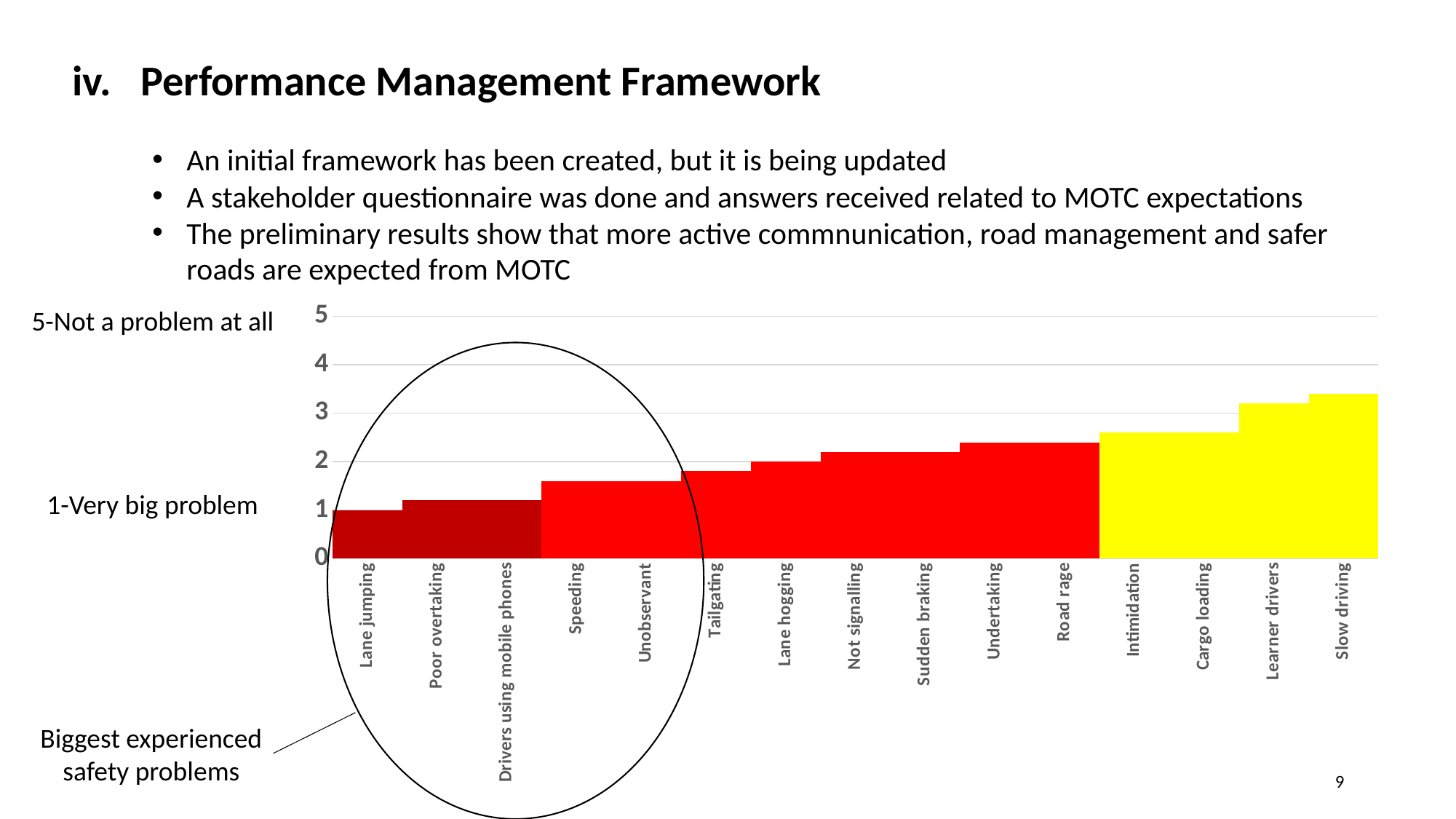
How many categories are plotted on the x axis of the chart? 15 Which has the larger value, Lane jumping or Undertaking? Undertaking Do the values rise or fall moving left to right along the x axis? rise Which category has the highest value in the chart? Slow driving Which category has the lowest value in the chart? Lane jumping Which has the larger value, Learner drivers or Tailgating? Learner drivers What kind of chart is shown on the slide? bar chart Is the value for Speeding greater or less than 2? less Is the value for Road rage greater or less than 2? greater Is the value for Learner drivers greater or less than 3? greater What colour are the bars for Intimidation, Cargo loading, Learner drivers and Slow driving? yellow